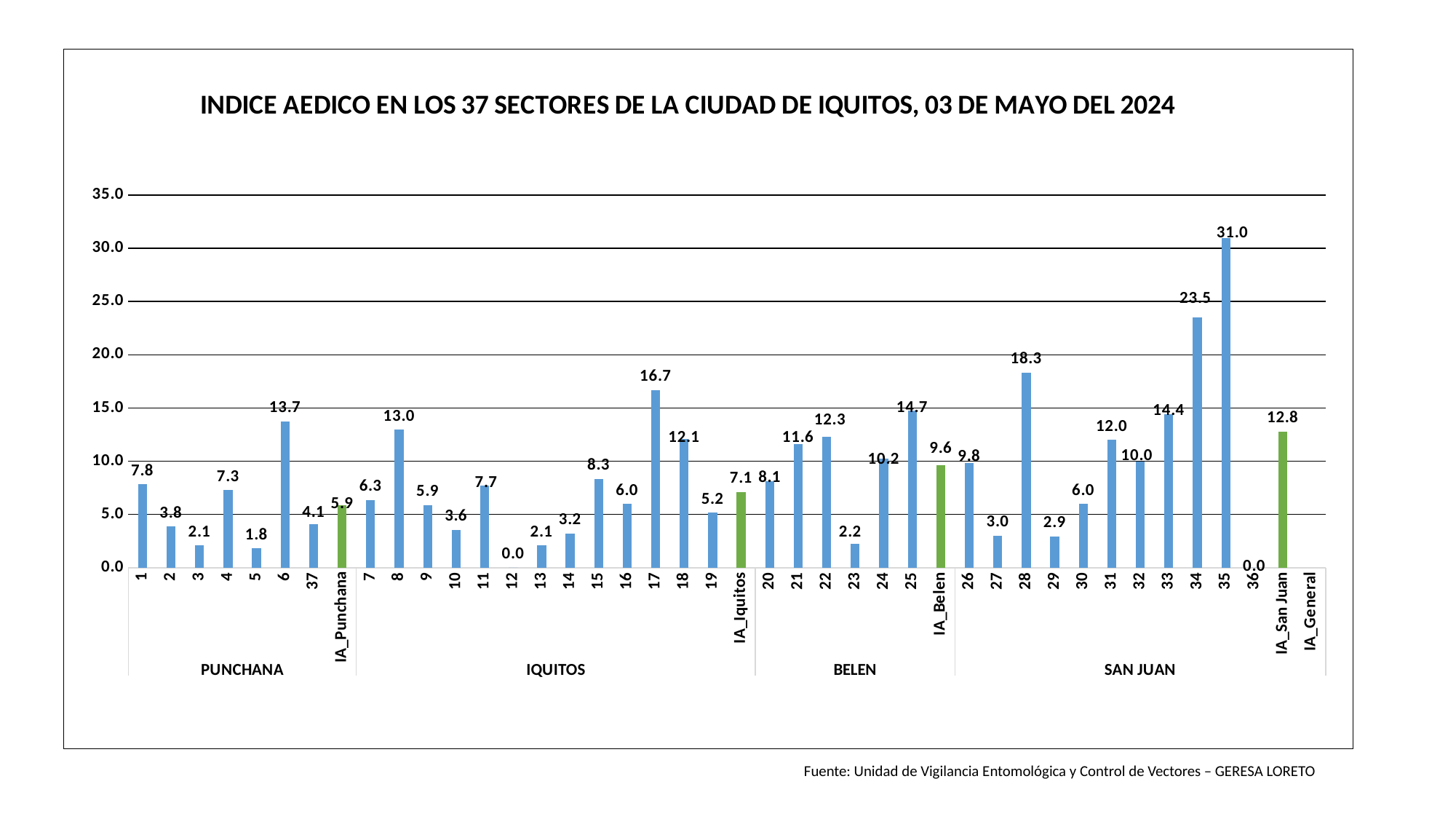
What is the value of the IA_Belen bar? 9.6 What is the difference between the values for sector 35 and sector 34? 7.5 How many district groups are labelled along the x axis? 4 What is the value of the IA_Punchana bar? 5.9 What is the title of the chart? INDICE AEDICO EN LOS 37 SECTORES DE LA CIUDAD DE IQUITOS, 03 DE MAYO DEL 2024 Which has a larger value, sector 6 or sector 8? Sector 6 What is the difference between the IA_San Juan value and the IA_Iquitos value? 5.7 What kind of chart is shown on the slide? Bar chart What is the value shown for sector 25? 14.7 What is the value shown for sector 17? 16.7 Which sector has the highest value in the chart? 35 Is the value for sector 28 greater or less than 15.0? greater